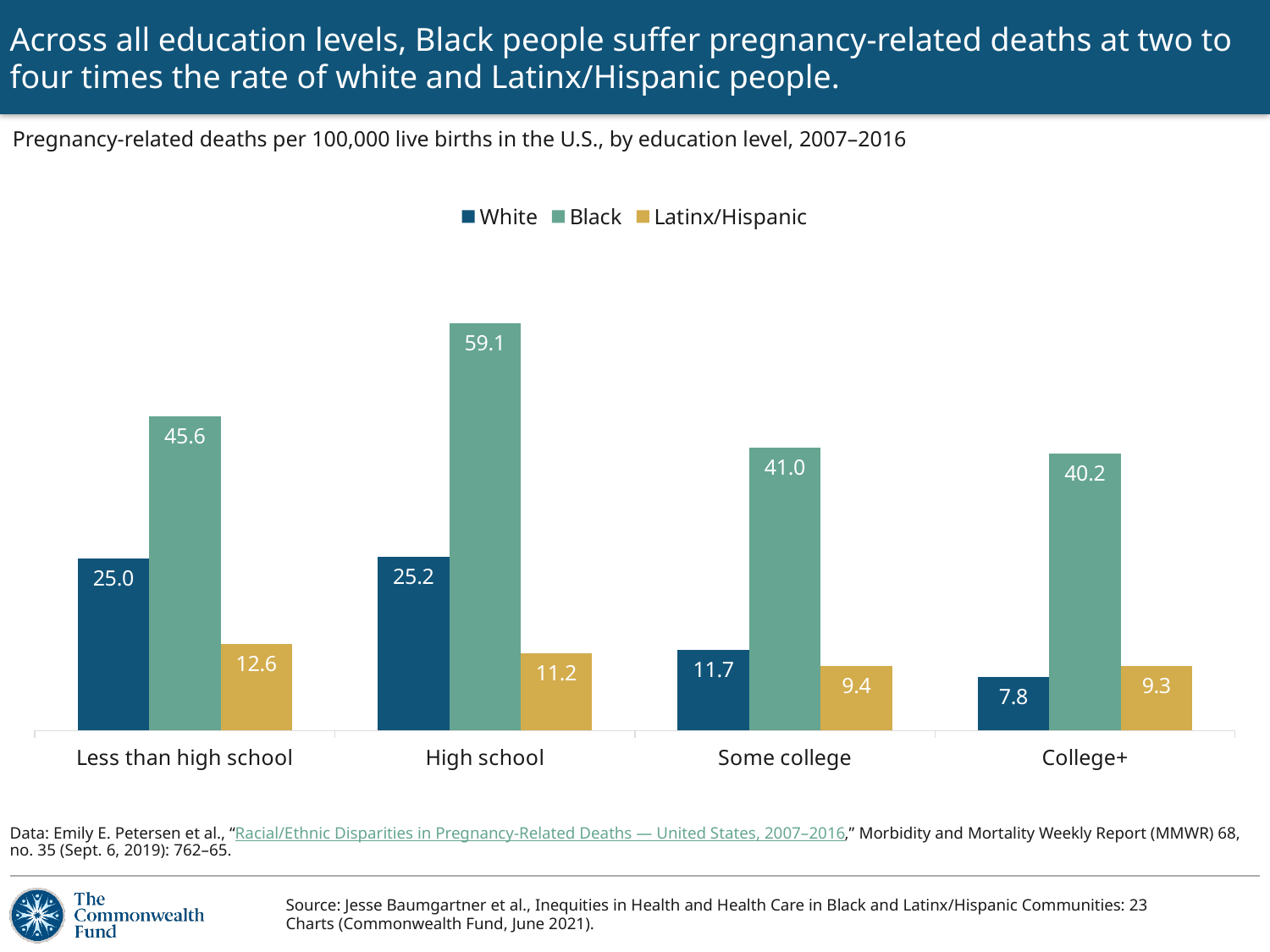
What is the pregnancy-related death rate for Black people with a high school education? 59.1 Do the values for White people rise or fall from Less than high school to College+? Fall Which education level has the lowest value for White people? College+ How many education level categories are shown on the x axis? 4 How many series does the legend list? 3 Which is larger: the Latinx/Hispanic value for Less than high school or for High school? Less than high school What kind of chart is shown on the slide? Bar chart What is the value for White people in the Some college category? 11.7 Which education level has the highest value for Black people? High school What is the value for Latinx/Hispanic people in the College+ category? 9.3 Which series is shown in yellow in the legend? Latinx/Hispanic What is the difference between the Black and White values in the Less than high school category? 20.6